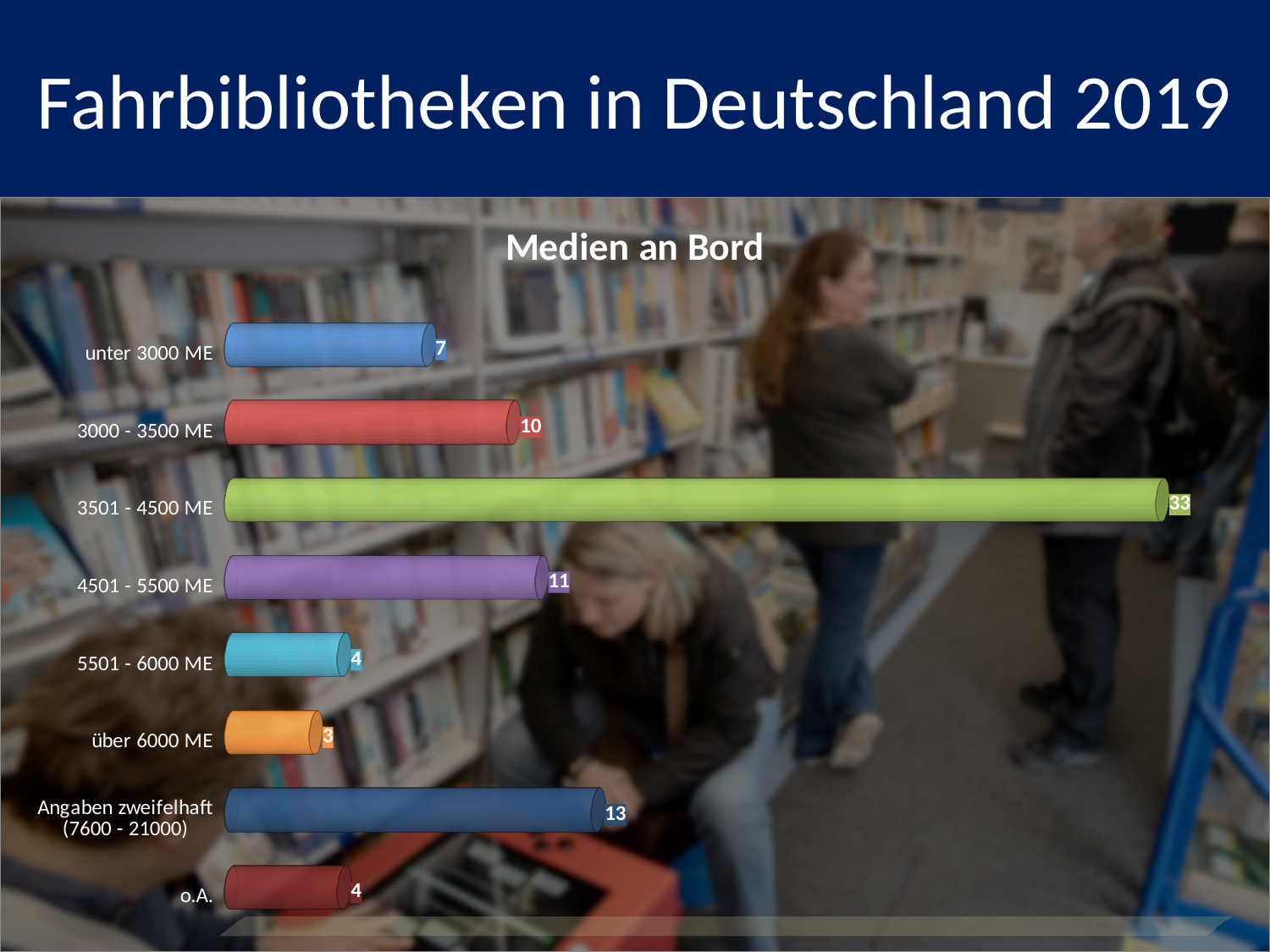
What is the value for the category "3501 - 4500 ME" in the "Medien an Bord" chart? 33 Which has the larger value in the "Medien an Bord" chart: "4501 - 5500 ME" or "3000 - 3500 ME"? 4501 - 5500 ME What is the value for "über 6000 ME" in the "Medien an Bord" chart? 3 What is the difference between the values for "3000 - 3500 ME" and "unter 3000 ME" in the "Medien an Bord" chart? 3 How many categories are shown in the "Medien an Bord" chart? 8 What kind of chart is the "Medien an Bord" chart? bar chart What is the value for "unter 3000 ME" in the "Medien an Bord" chart? 7 Which category has the highest value in the "Medien an Bord" chart? 3501 - 4500 ME What is the difference between the values for "3501 - 4500 ME" and "4501 - 5500 ME" in the "Medien an Bord" chart? 22 What is the title of the chart on the slide? Medien an Bord Which category has the lowest value in the "Medien an Bord" chart? über 6000 ME What is the value for "Angaben zweifelhaft (7600 - 21000)" in the "Medien an Bord" chart? 13